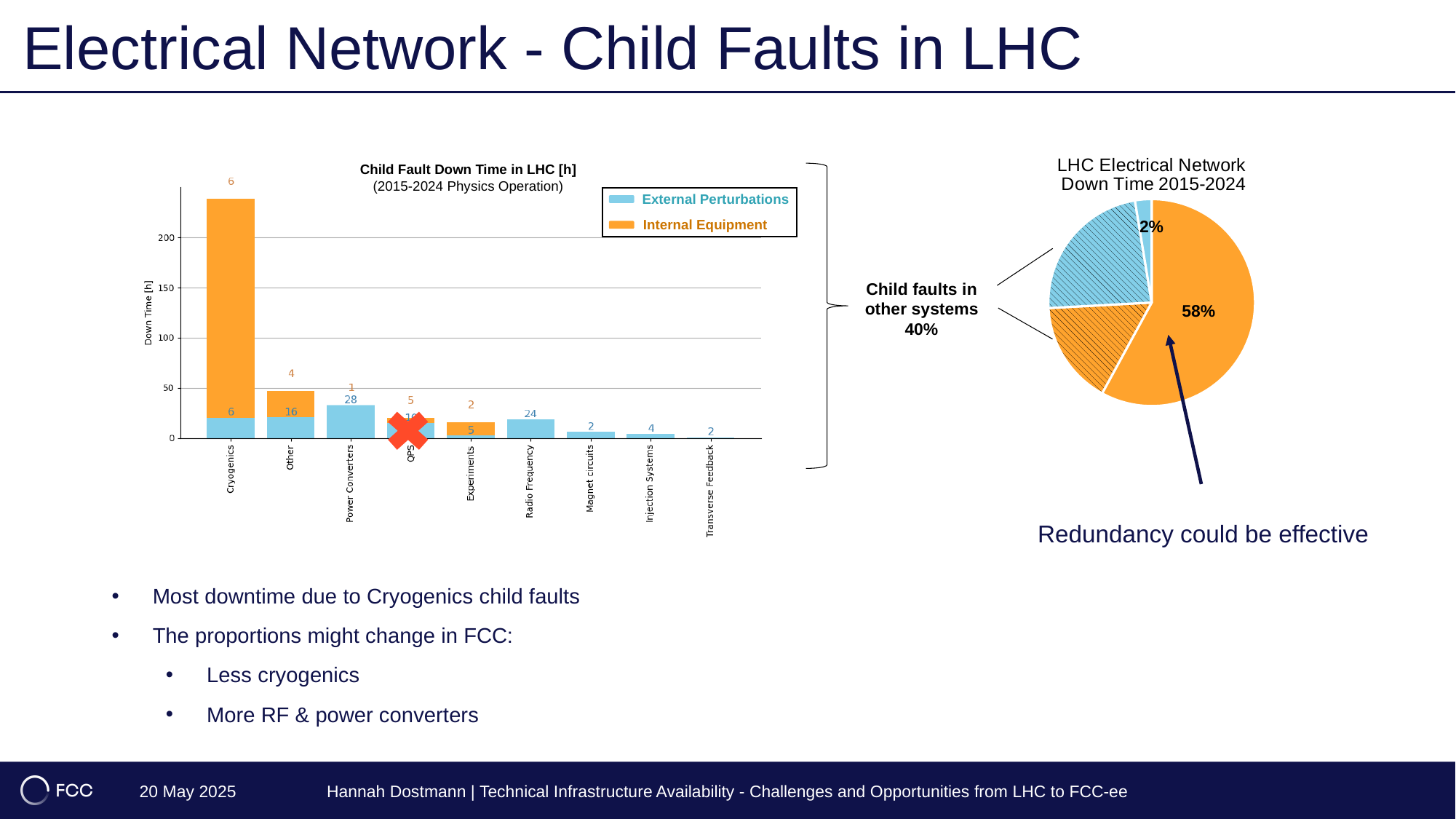
How many categories are shown on the x axis of the 'Child Fault Down Time in LHC [h]' chart? 9 In the 'Child Fault Down Time in LHC [h]' chart, which category has the lowest total down time? Transverse Feedback In the 'Child Fault Down Time in LHC [h]' chart, is the total down time for Power Converters greater or less than 50? less In the 'Child Fault Down Time in LHC [h]' chart, is the total down time for Cryogenics greater or less than 200? greater How many series does the legend of the 'Child Fault Down Time in LHC [h]' chart list? 2 What are the two legend entries of the 'Child Fault Down Time in LHC [h]' chart? External Perturbations and Internal Equipment In the 'Child Fault Down Time in LHC [h]' chart, which category has the highest total down time? Cryogenics What kind of chart is the 'Child Fault Down Time in LHC [h]' chart? bar chart In the 'LHC Electrical Network Down Time 2015-2024' pie chart, what share is attributed to child faults in other systems? 40% In the 'LHC Electrical Network Down Time 2015-2024' pie chart, what share does the largest orange slice represent? 58% In the 'Child Fault Down Time in LHC [h]' chart, which has the larger total down time, Power Converters or Radio Frequency? Power Converters In the 'Child Fault Down Time in LHC [h]' chart, is the total down time for Other greater or less than 100? less